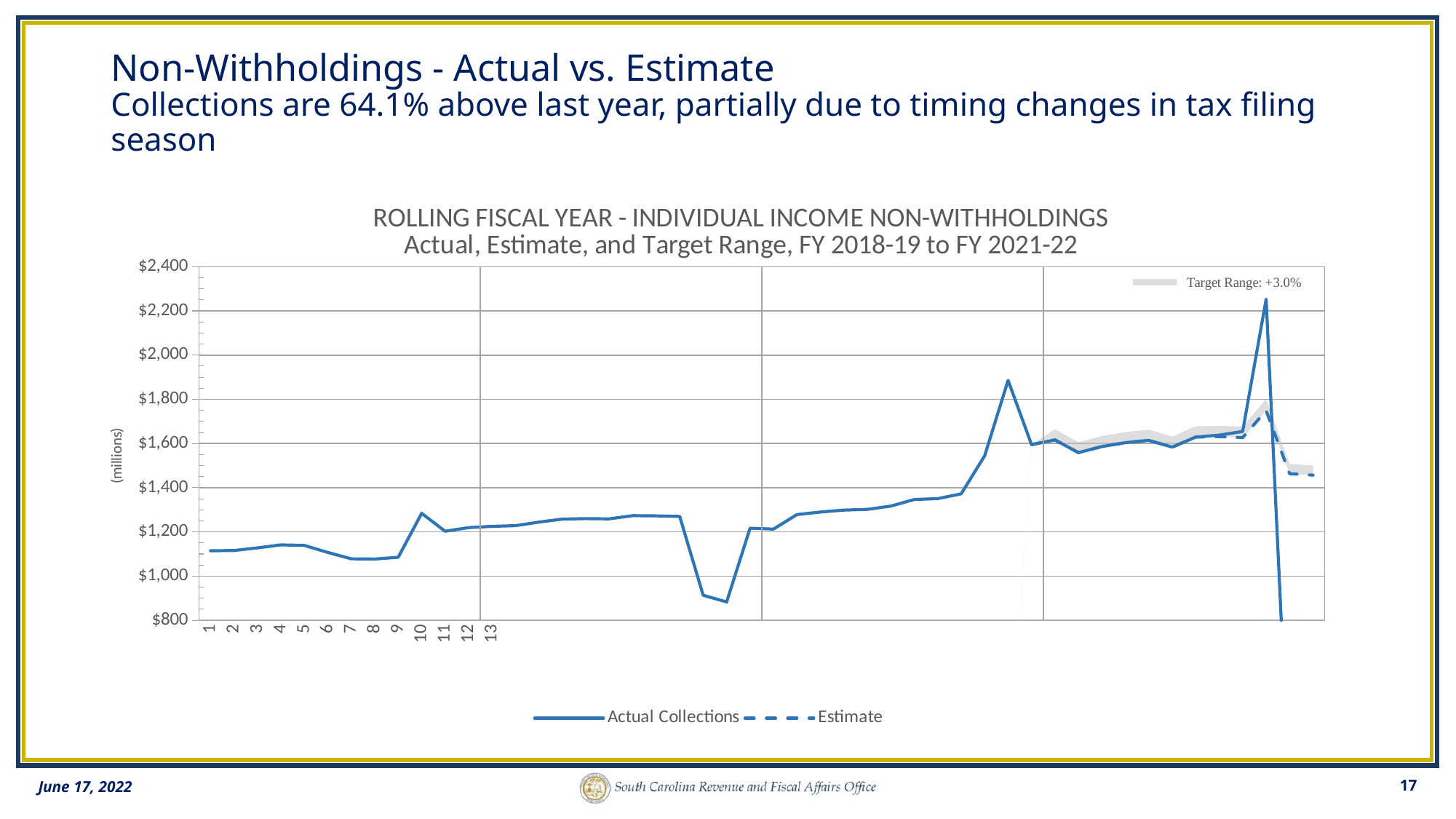
Is the highest value reached by the Actual Collections line greater or less than $2,200? greater Do the Actual Collections values generally rise or fall from point 1 to point 13? rise Is the Actual Collections value at point 5 greater or less than $1,000? greater What unit is shown on the vertical axis label of the chart? (millions) How many series does the chart legend at the bottom list? 2 What is the lowest value shown on the vertical axis of the chart? $800 What are the two series named in the chart legend? Actual Collections and Estimate Which series is drawn with a dashed line, Actual Collections or Estimate? Estimate Is the Actual Collections value at point 10 greater or less than $1,200? greater What kind of chart is shown on the slide? line chart